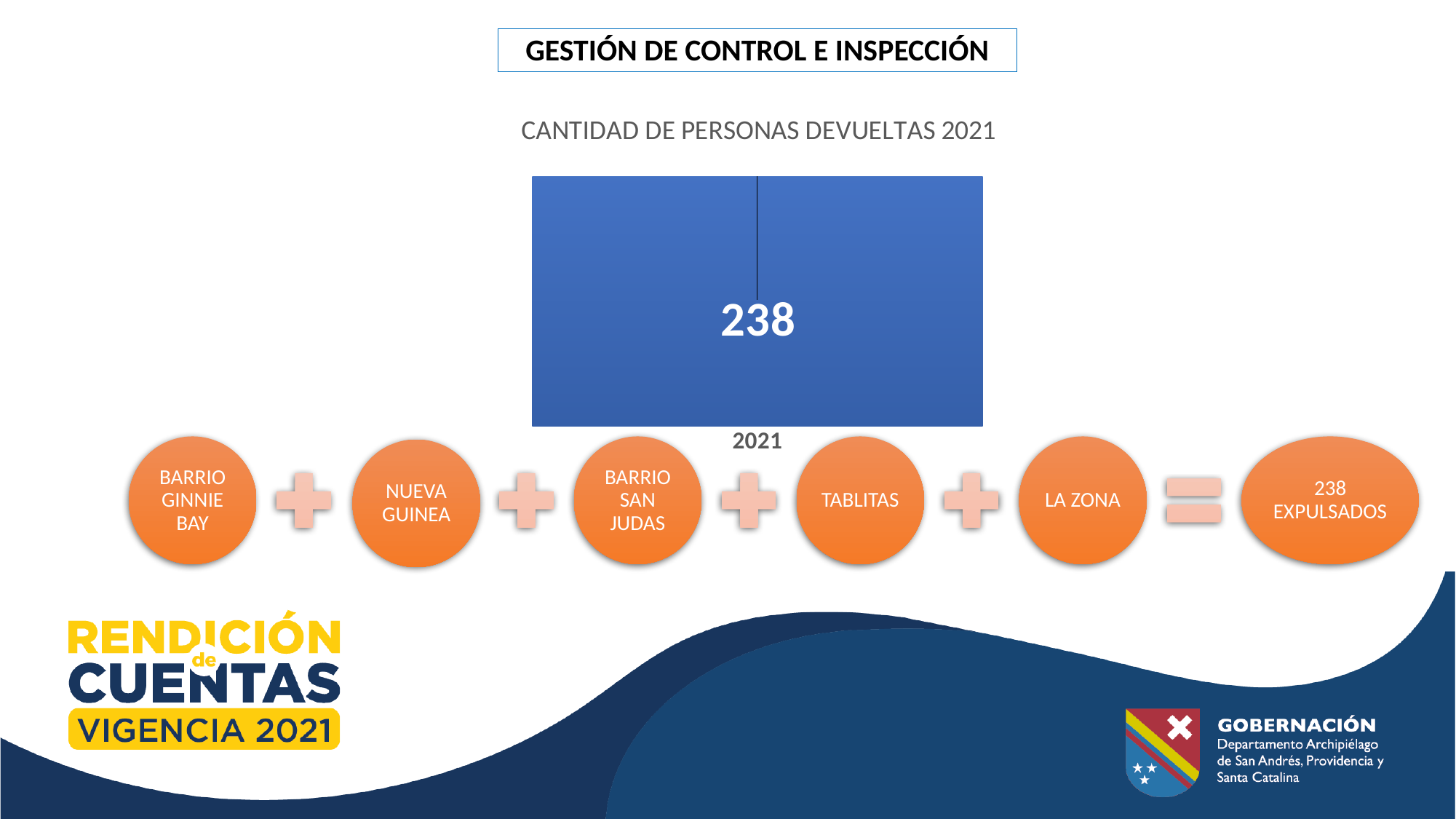
What category label appears under the bar in the chart? 2021 What colour is the bar in the chart? blue What is the title of the chart? CANTIDAD DE PERSONAS DEVUELTAS 2021 What is the value shown for 2021 in the chart? 238 What kind of chart is shown on the slide? bar chart How many bars does the chart have? 1